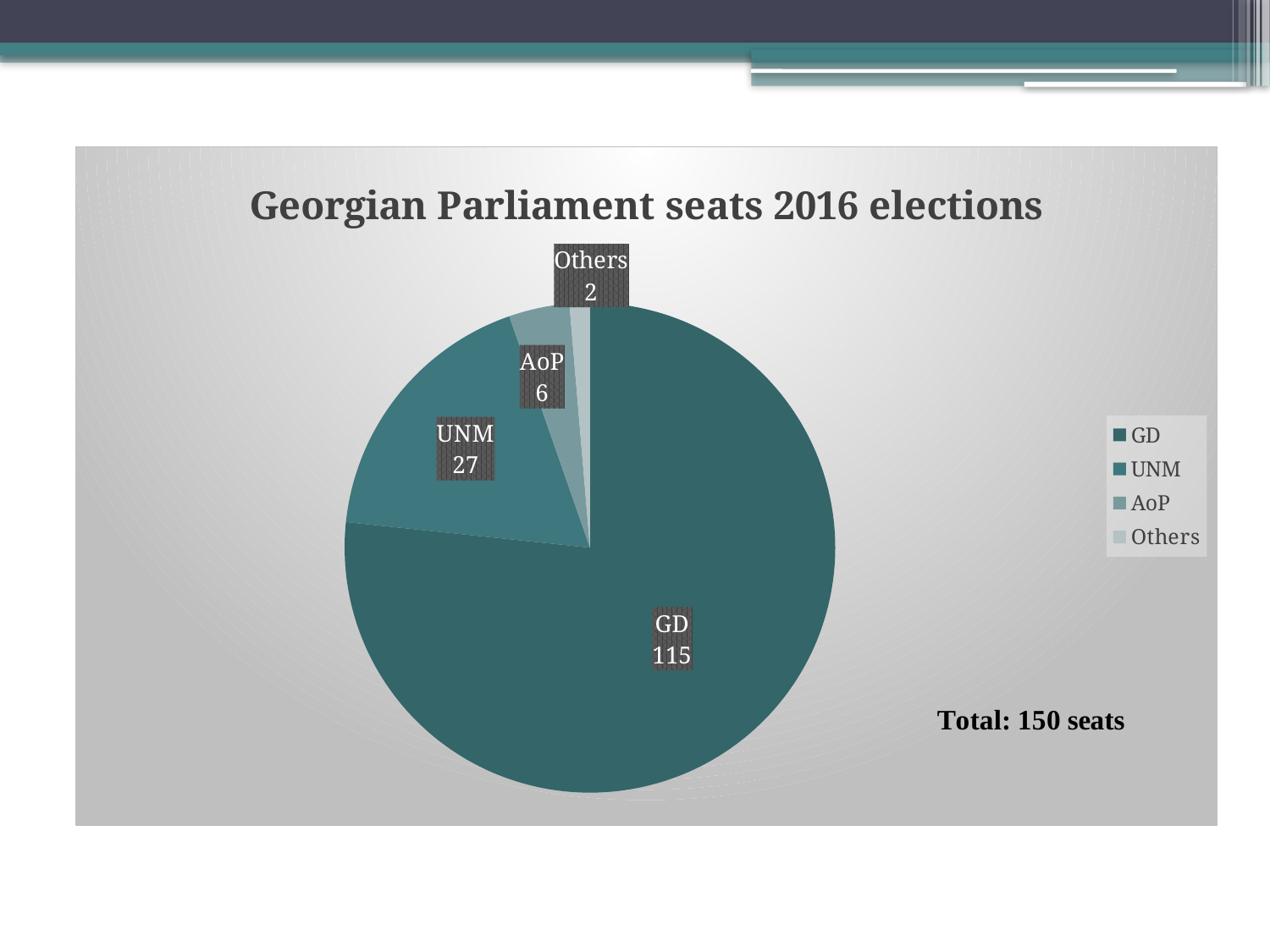
What total number of seats is stated on the slide? 150 seats How many categories does the pie chart show? 4 How many seats does GD have according to the chart? 115 How many seats does AoP have according to the chart? 6 How many seats does UNM have according to the chart? 27 Which category has the smallest slice of the pie? Others How many seats are labelled for Others? 2 What is the difference in seats between GD and UNM? 88 What is the title of the chart? Georgian Parliament seats 2016 elections What kind of chart is shown on the slide? pie chart Which has more seats, UNM or AoP? UNM Which party has the largest slice of the pie? GD